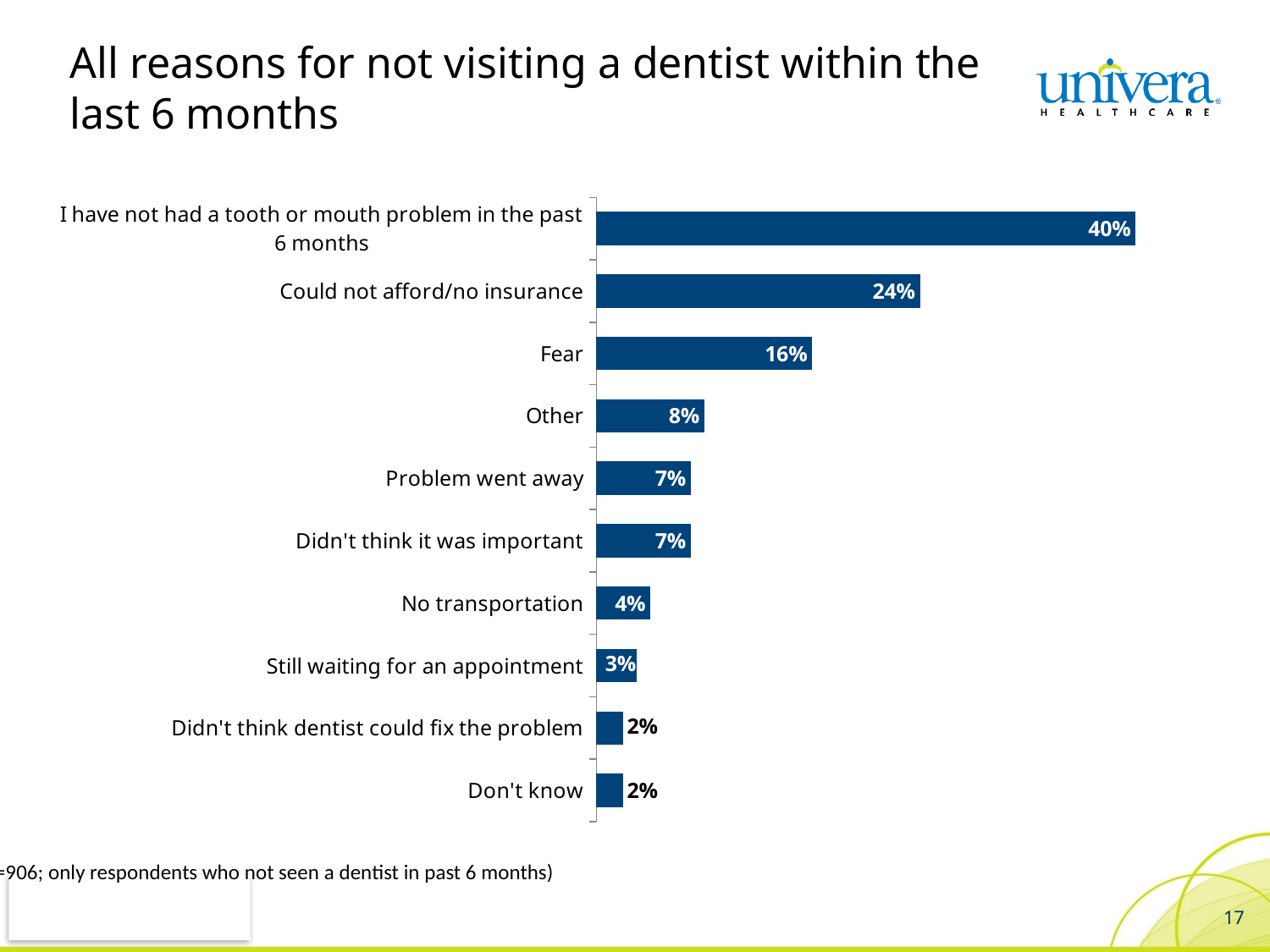
What is the difference in percentage points between 'Fear' and 'Other'? 8 What is the title of the slide containing the chart? All reasons for not visiting a dentist within the last 6 months What is the value shown for 'Fear'? 16% What is the value for 'Still waiting for an appointment'? 3% What percentage of respondents gave 'Could not afford/no insurance' as a reason for not visiting a dentist? 24% How many reasons (categories) are shown in the chart? 10 What percentage is shown for 'No transportation'? 4% Which reason has the highest percentage? I have not had a tooth or mouth problem in the past 6 months What is the difference in percentage points between 'I have not had a tooth or mouth problem in the past 6 months' and 'Could not afford/no insurance'? 16 Which two reasons share the lowest value of 2%? Didn't think dentist could fix the problem; Don't know What type of chart is shown on the slide? Bar chart Which is larger, the value for 'Other' or the value for 'Problem went away'? Other